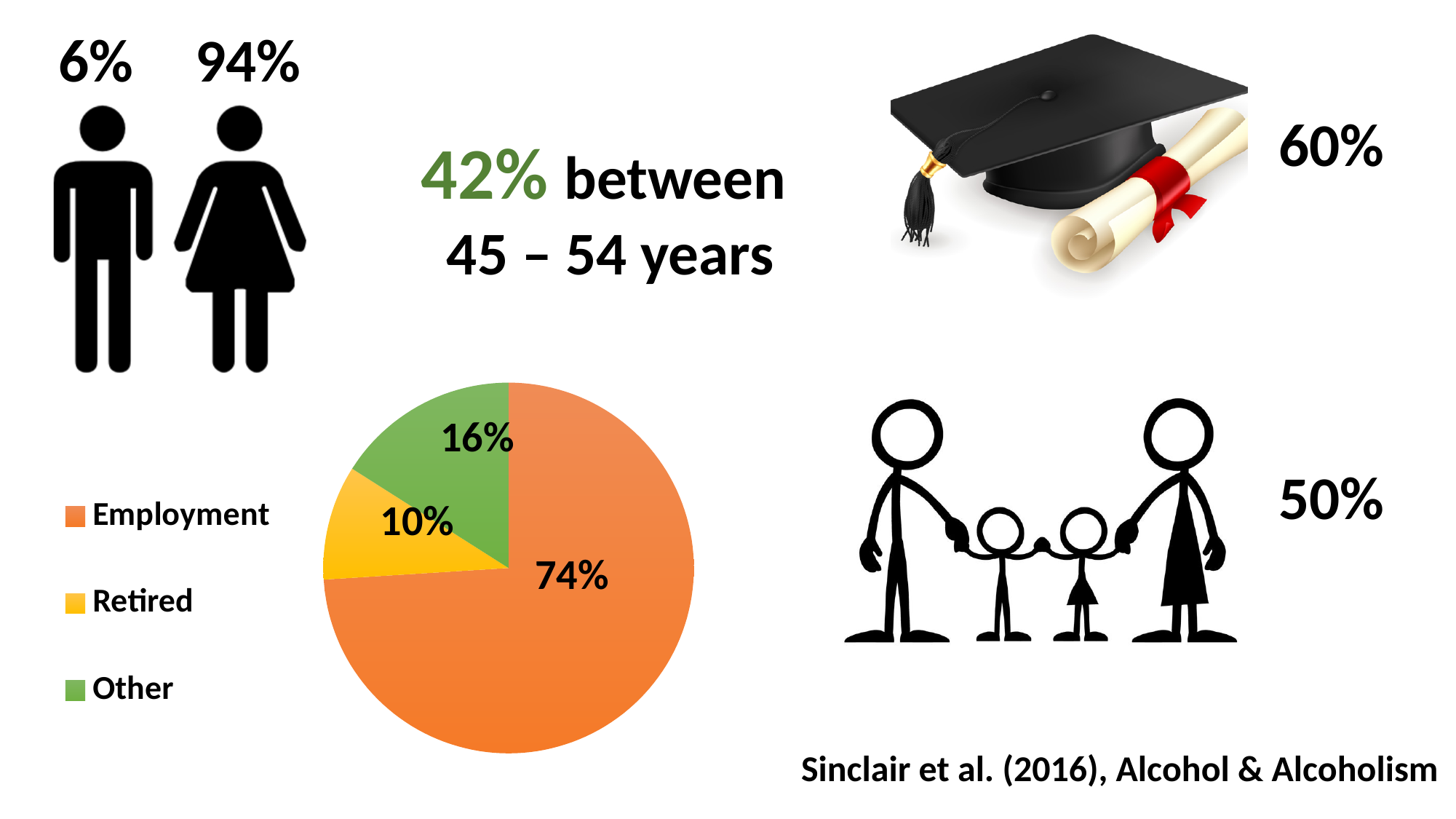
What kind of chart is shown on the slide? pie chart How many categories does the pie chart show? 3 What share of the pie chart is Retired? 10% Which category has the largest slice in the pie chart? Employment Which slice is larger in the pie chart, Retired or Other? Other What is the difference in percentage points between the Other and Retired slices? 6 Which category has the smallest slice in the pie chart? Retired What is the difference in percentage points between the Employment and Other slices? 58 What share of the pie chart is Other? 16% Which category in the legend is shown in yellow? Retired What colour is the Employment slice in the pie chart? orange What share of the pie chart is Employment? 74%